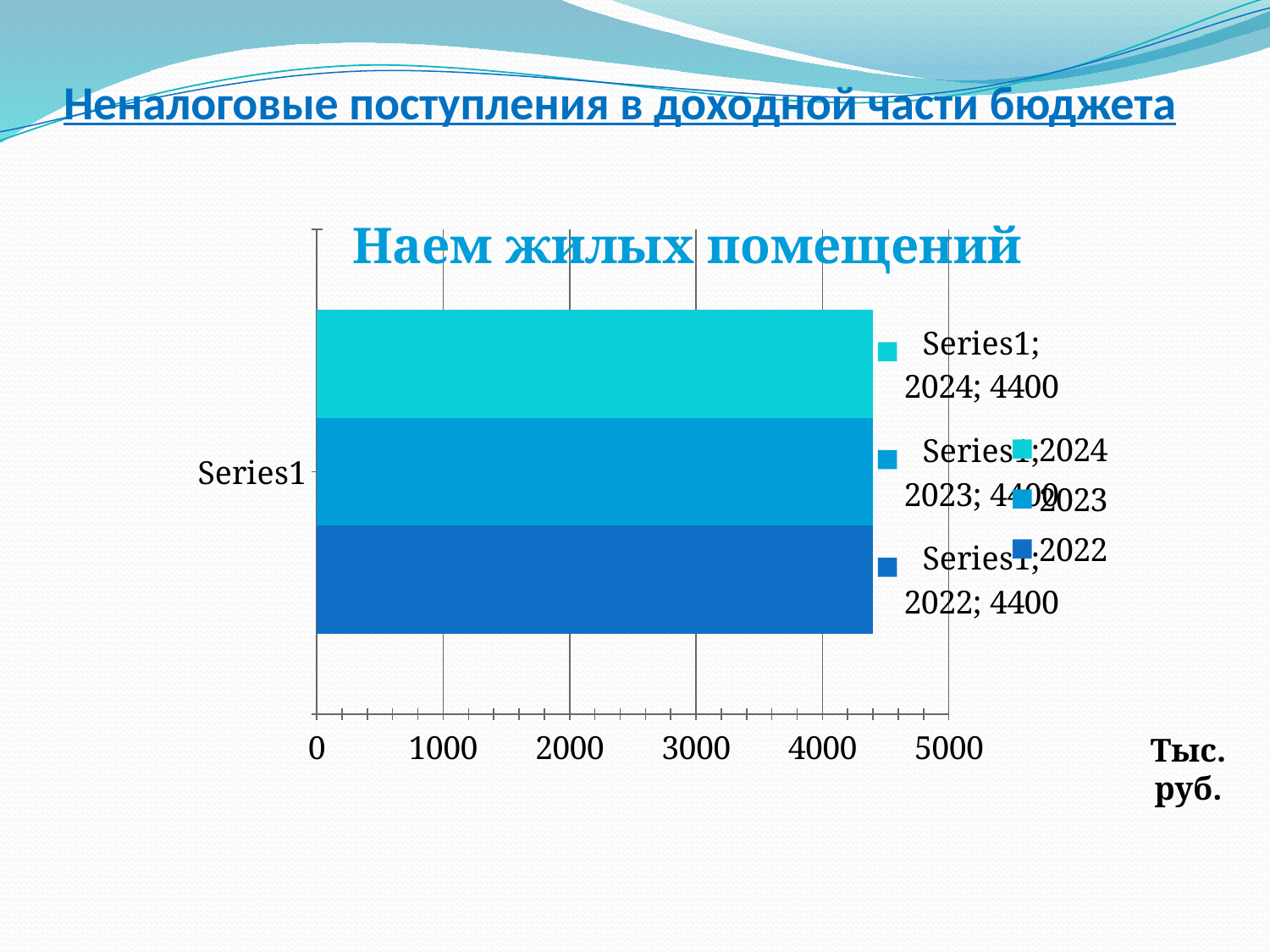
Is the value for 2024 greater or less than 4000? greater What unit is indicated next to the chart's axis? Тыс. руб. What kind of chart is shown on the slide? Bar chart What is the difference between the values for 2024 and 2022? 0 What is the value for 2022 in the chart? 4400 Is the value for 2022 greater or less than 5000? less How many bars are plotted in the chart? 3 What is the value for 2023 in the chart? 4400 What is the value for 2024 in the chart? 4400 What is the title of the chart? Наем жилых помещений Do the values change from 2022 to 2024? No, they stay the same How many entries does the legend list? 3